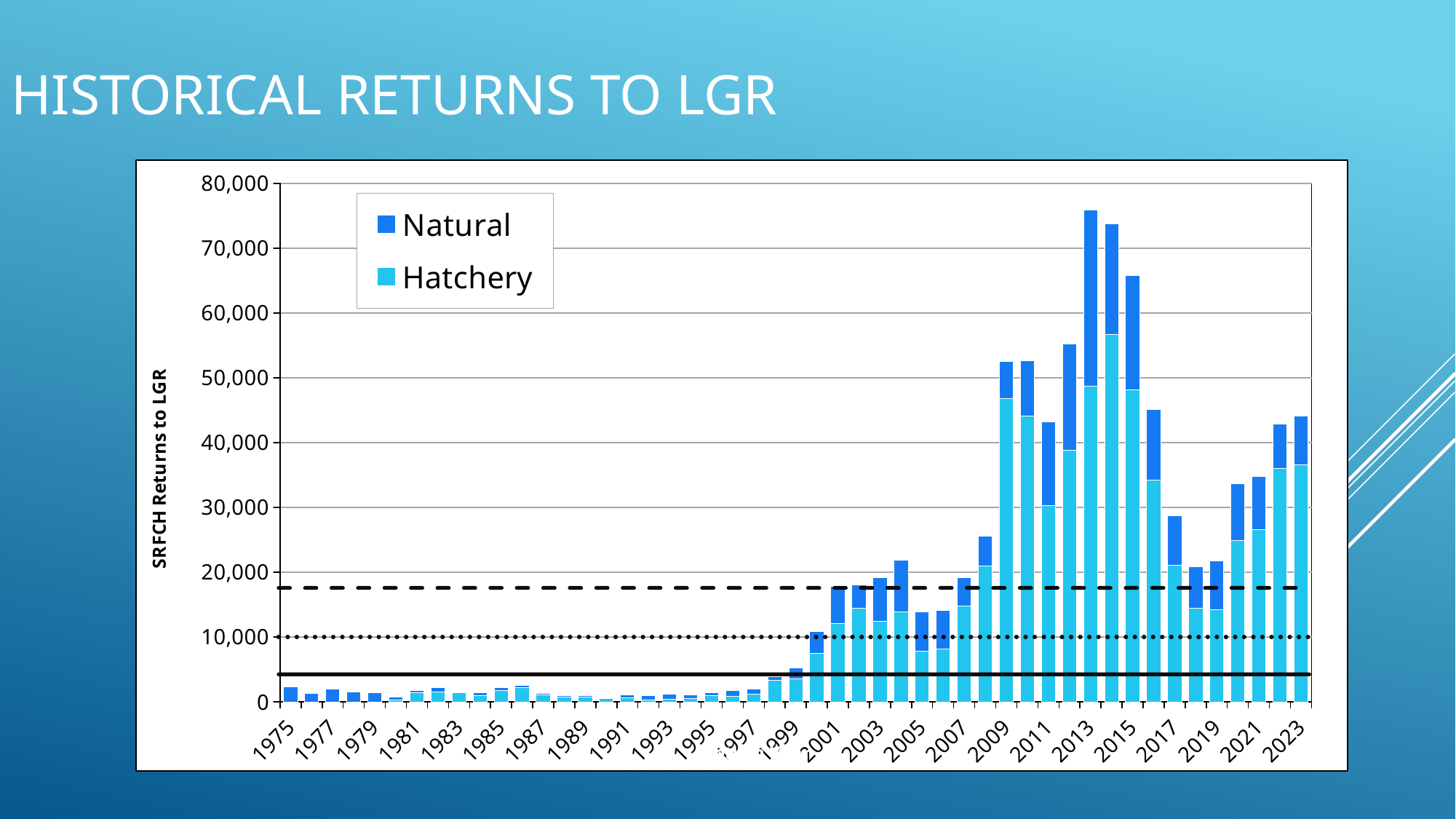
What kind of chart is shown on the slide? Stacked bar chart Which year has the highest total returns to LGR? 2013 How many series does the legend list? 2 Do the total returns rise or fall from 2018 to 2023? rise Which year has the larger total, 2011 or 2013? 2013 Is the total value for 2023 greater or less than 40,000? greater Is the total value for 2009 greater or less than 50,000? greater Is the total value for 1999 greater or less than 10,000? less What is the label on the vertical axis? SRFCH Returns to LGR Which year has the larger total, 2014 or 2015? 2014